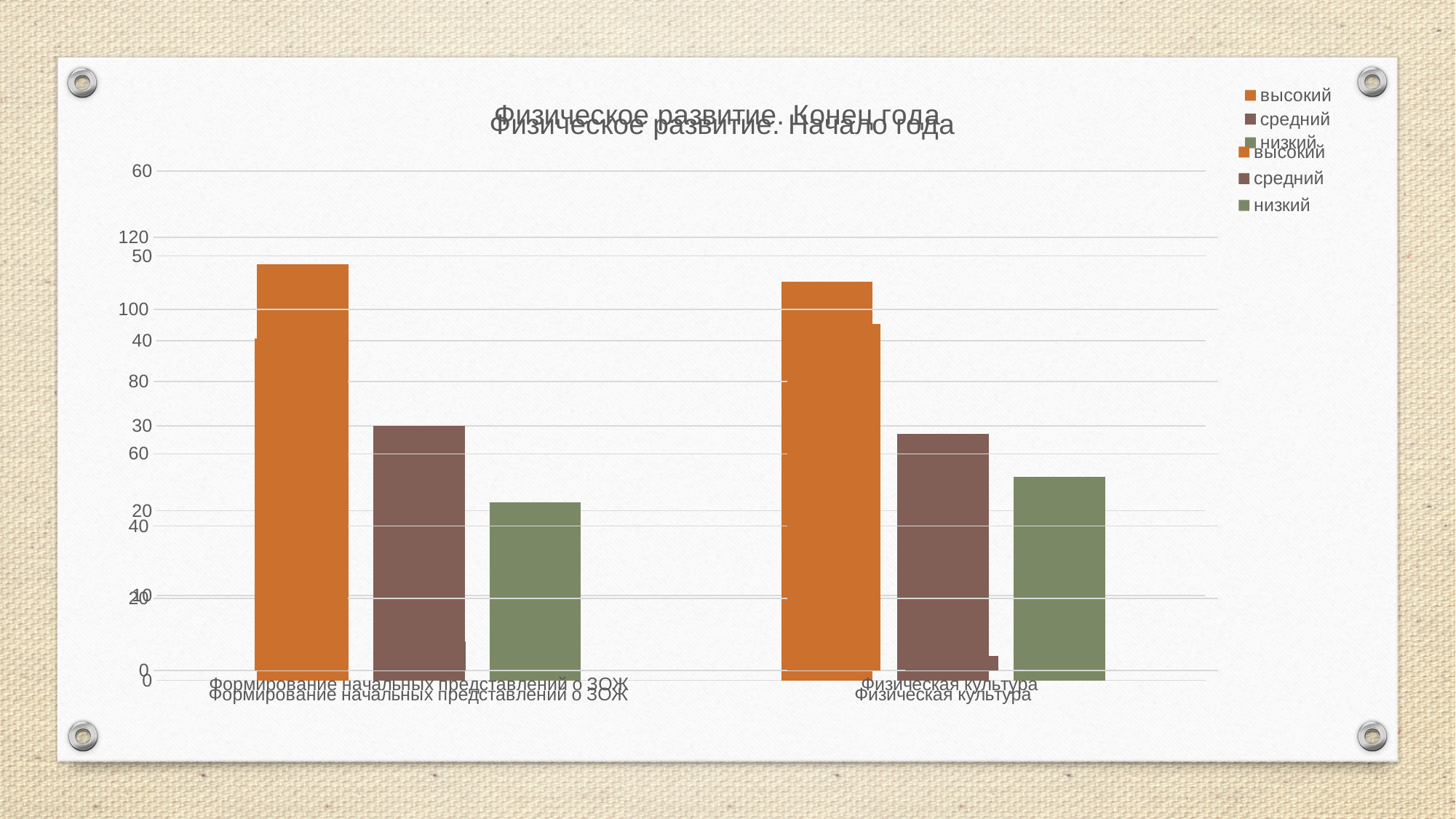
How many series does the legend list for the chart whose vertical axis runs from 0 to 60? 3 In the chart whose vertical axis runs from 0 to 60, is the value of низкий for Формирование начальных представлений о ЗОЖ greater or less than 30? less In the chart whose vertical axis runs from 0 to 60, is the value of высокий for Формирование начальных представлений о ЗОЖ greater or less than 40? greater What are the legend entries of the chart whose vertical axis runs from 0 to 60? высокий, средний, низкий In the chart whose vertical axis runs from 0 to 60, which series has the highest bar for Формирование начальных представлений о ЗОЖ? высокий In the chart whose vertical axis runs from 0 to 60, which category has the larger низкий bar: Формирование начальных представлений о ЗОЖ or Физическая культура? Физическая культура In the chart whose vertical axis runs from 0 to 60, is the value of средний for Физическая культура greater or less than 20? greater In the chart whose vertical axis runs from 0 to 60, which series has the lowest bar for Физическая культура? низкий What kind of chart is shown on the slide? bar chart How many categories are shown on the x axis of the chart whose vertical axis runs from 0 to 60? 2